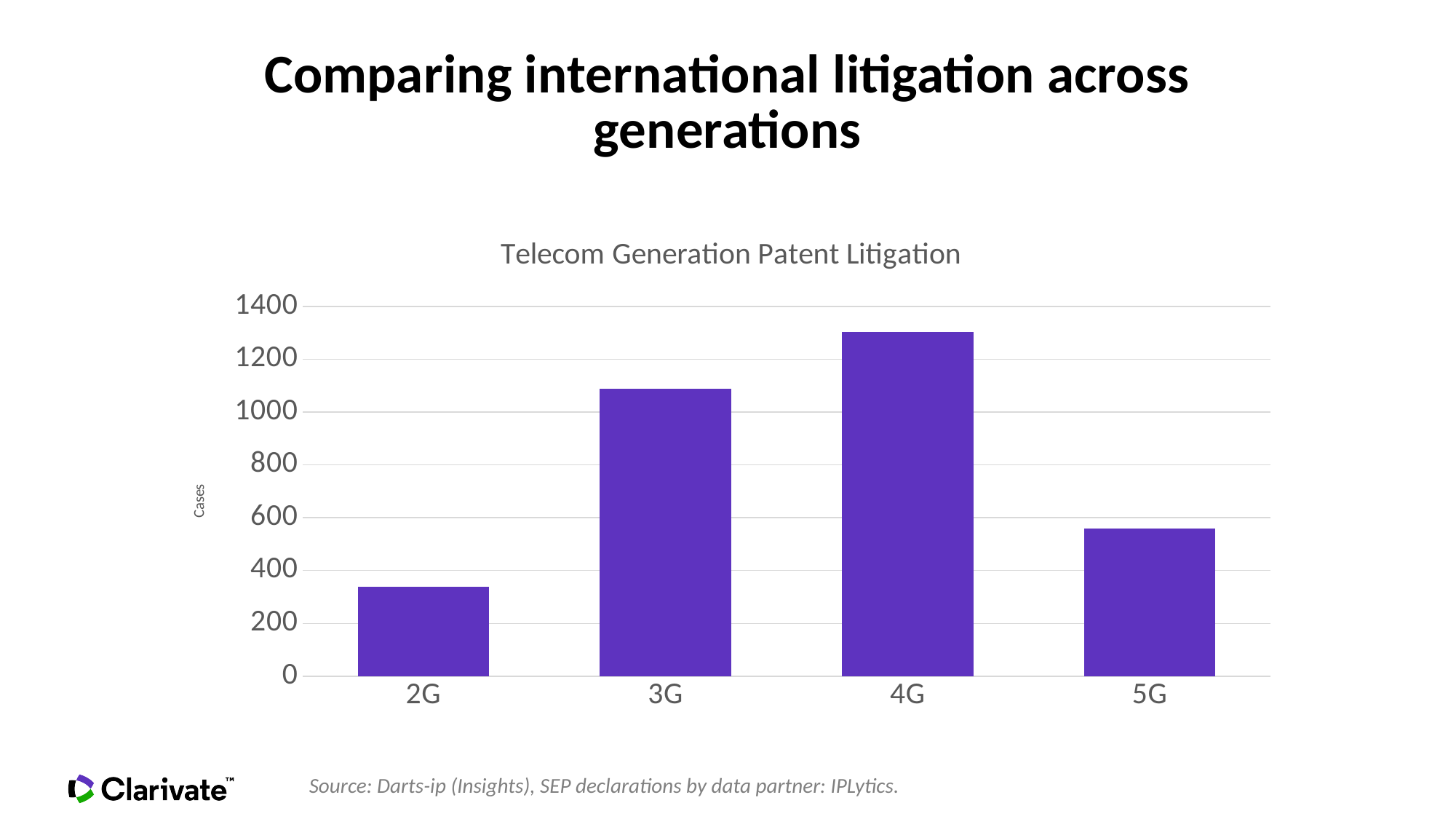
How many telecom generations are plotted on the chart? 4 Is the value for 4G greater or less than 1200? greater Is the value for 5G greater or less than 600? less What label is shown on the vertical axis? Cases Which has more cases, 2G or 5G? 5G Which telecom generation has the highest number of cases? 4G Which telecom generation has the lowest number of cases? 2G What is the title of the chart? Telecom Generation Patent Litigation What kind of chart is shown on the slide? bar chart Is the value for 2G greater or less than 400? less Which has more cases, 3G or 5G? 3G